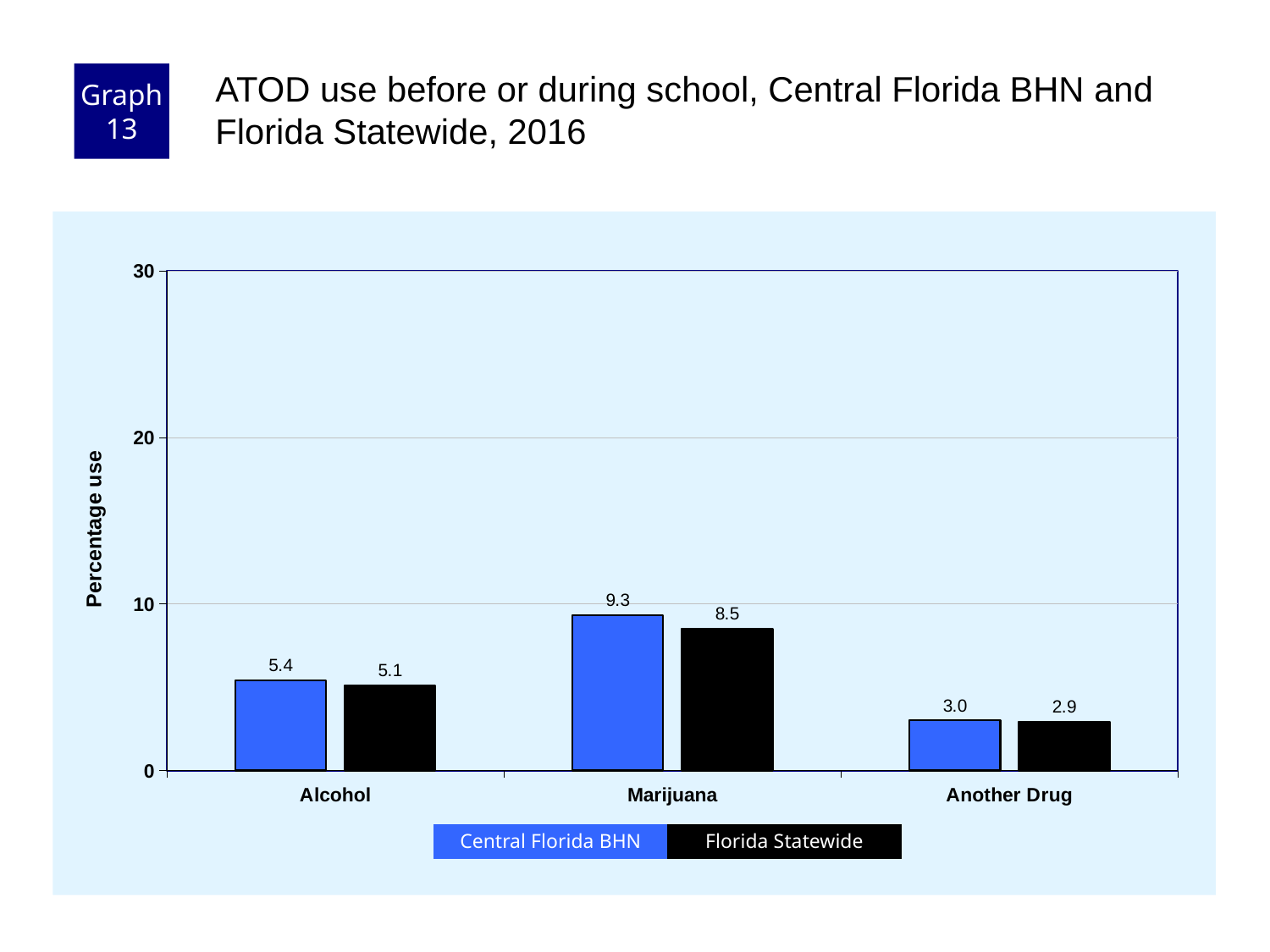
What is the Central Florida BHN value for Marijuana? 9.3 How many series does the legend list? 2 Which category has the highest Central Florida BHN value? Marijuana Is the Central Florida BHN value for Marijuana greater or less than 10? less How many categories are shown on the x axis? 3 What is the difference between the Central Florida BHN values for Marijuana and Alcohol? 3.9 What kind of chart is shown on the slide? bar chart What is the Florida Statewide value for Another Drug? 2.9 What is the difference between the Central Florida BHN and Florida Statewide values for Marijuana? 0.8 Which is larger: the Central Florida BHN value for Alcohol or the Central Florida BHN value for Another Drug? Alcohol What is the Florida Statewide value for Alcohol? 5.1 Which category has the lowest Florida Statewide value? Another Drug